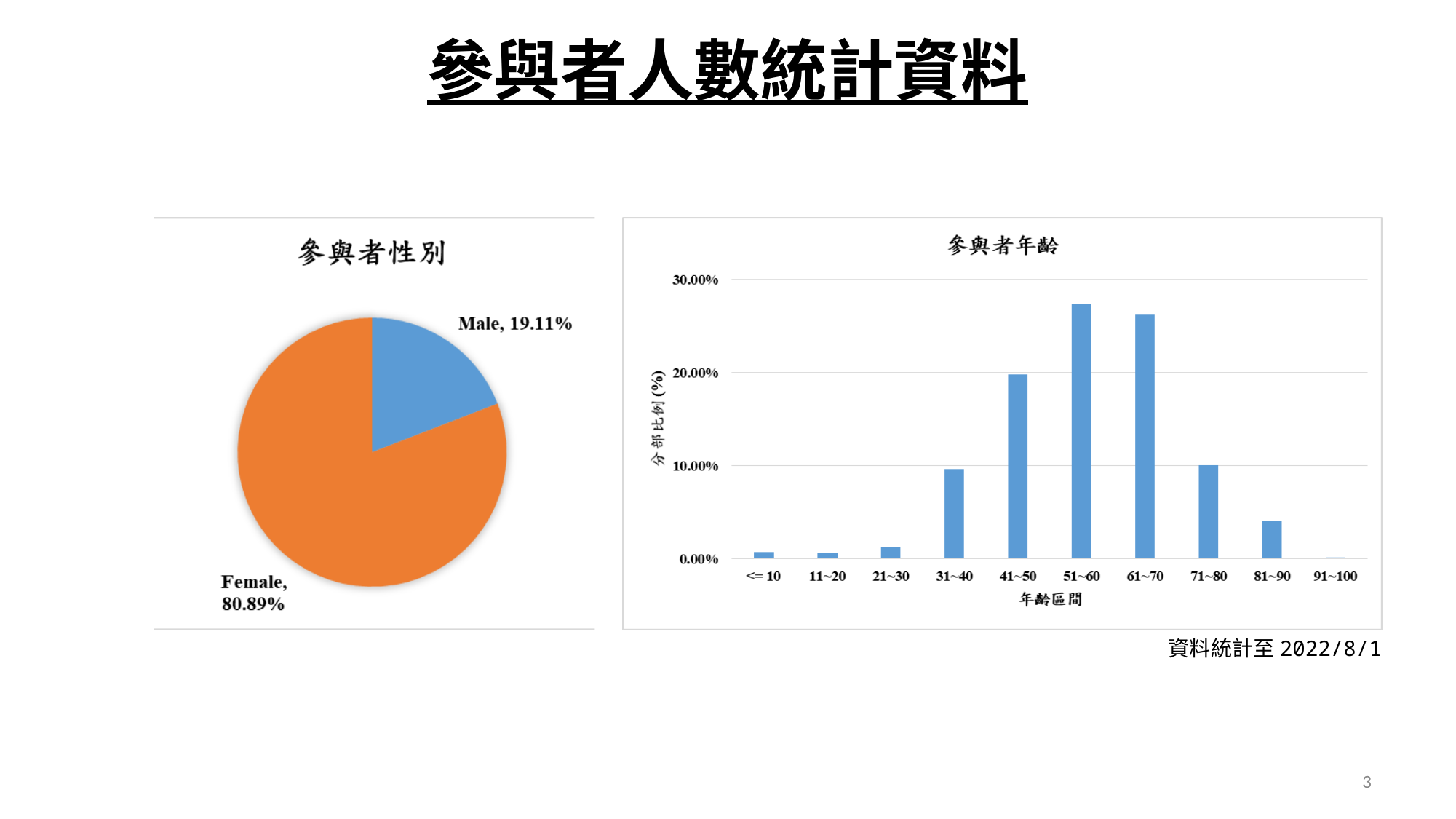
In the pie chart titled 參與者性別, what percentage is shown for Male? 19.11% In the bar chart titled 參與者年齡, is the value for 81~90 greater or less than 10.00%? less In the bar chart titled 參與者年齡, is the value for 51~60 greater or less than 20.00%? greater What kind of chart is the chart on the right titled 參與者年齡? Bar chart In the bar chart titled 參與者年齡, which is larger, the value for 41~50 or the value for 31~40? 41~50 In the pie chart titled 參與者性別, what percentage is shown for Female? 80.89% In the bar chart titled 參與者年齡, how many age groups are shown on the x axis? 10 In the pie chart titled 參與者性別, which category has the larger share? Female In the bar chart titled 參與者年齡, which age group has the lowest value? 91~100 In the pie chart titled 參與者性別, what is the difference between the Female and Male percentages? 61.78% What kind of chart is the chart on the left titled 參與者性別? Pie chart In the pie chart titled 參與者性別, how many slices are there? 2